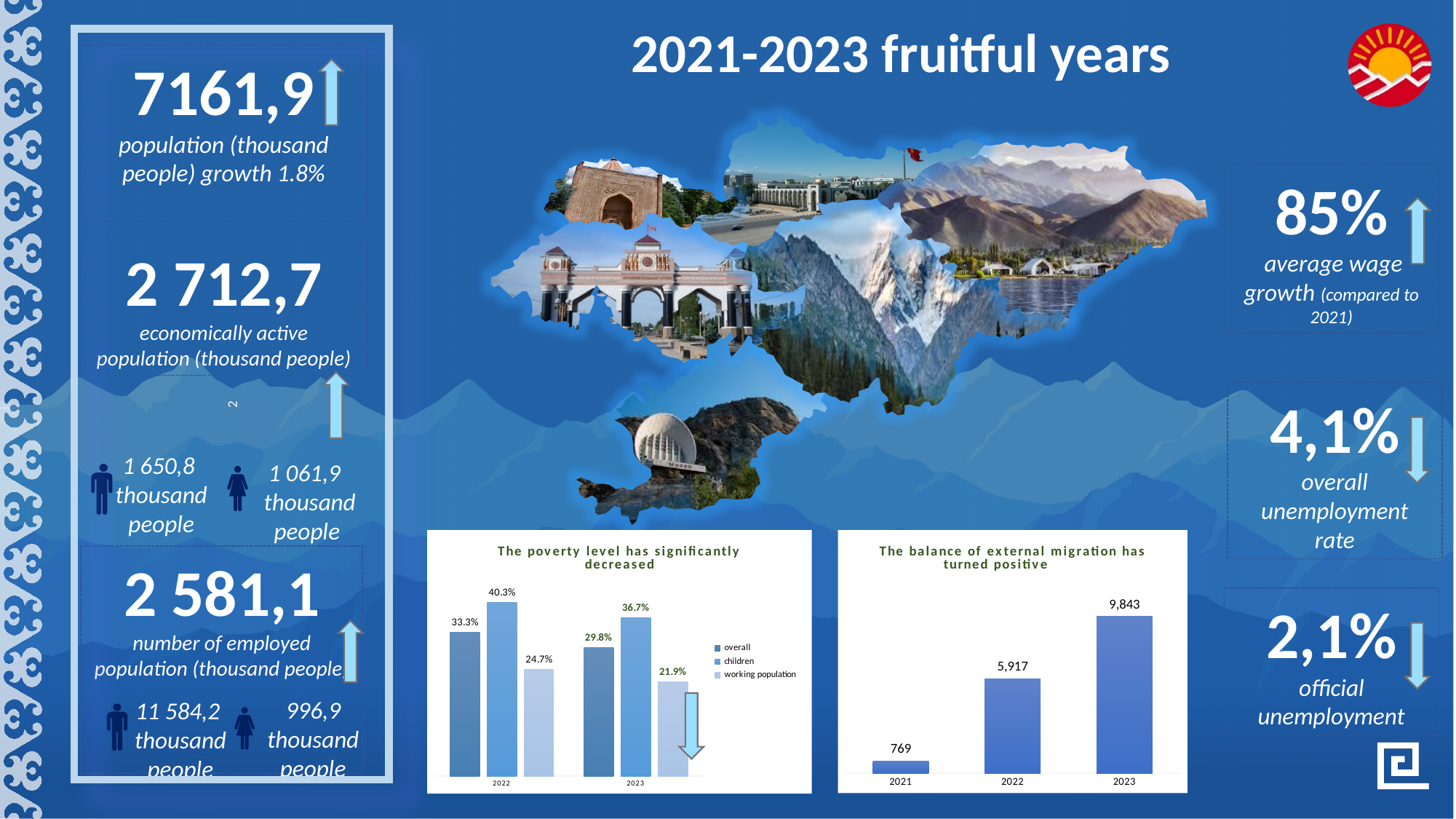
In the chart titled "The balance of external migration has turned positive", do the values rise or fall from 2021 to 2023? rise In the chart titled "The balance of external migration has turned positive", what is the difference between the 2023 and 2022 values? 3,926 In the chart titled "The poverty level has significantly decreased", is the value for children in 2023 larger or smaller than the value for children in 2022? smaller What kind of chart is the one titled "The balance of external migration has turned positive"? bar chart In the chart titled "The poverty level has significantly decreased", what is the overall value for 2023? 29.8% In the chart titled "The balance of external migration has turned positive", what is the value for 2022? 5,917 In the chart titled "The poverty level has significantly decreased", which series has the highest value in 2022? children In the chart titled "The poverty level has significantly decreased", how many series does the legend list? 3 In the chart titled "The balance of external migration has turned positive", which year has the lowest value? 2021 In the chart titled "The poverty level has significantly decreased", by how many percentage points did the overall value fall from 2022 to 2023? 3.5 In the chart titled "The poverty level has significantly decreased", what is the value for children in 2022? 40.3% In the chart titled "The poverty level has significantly decreased", what is the value for the working population in 2023? 21.9%